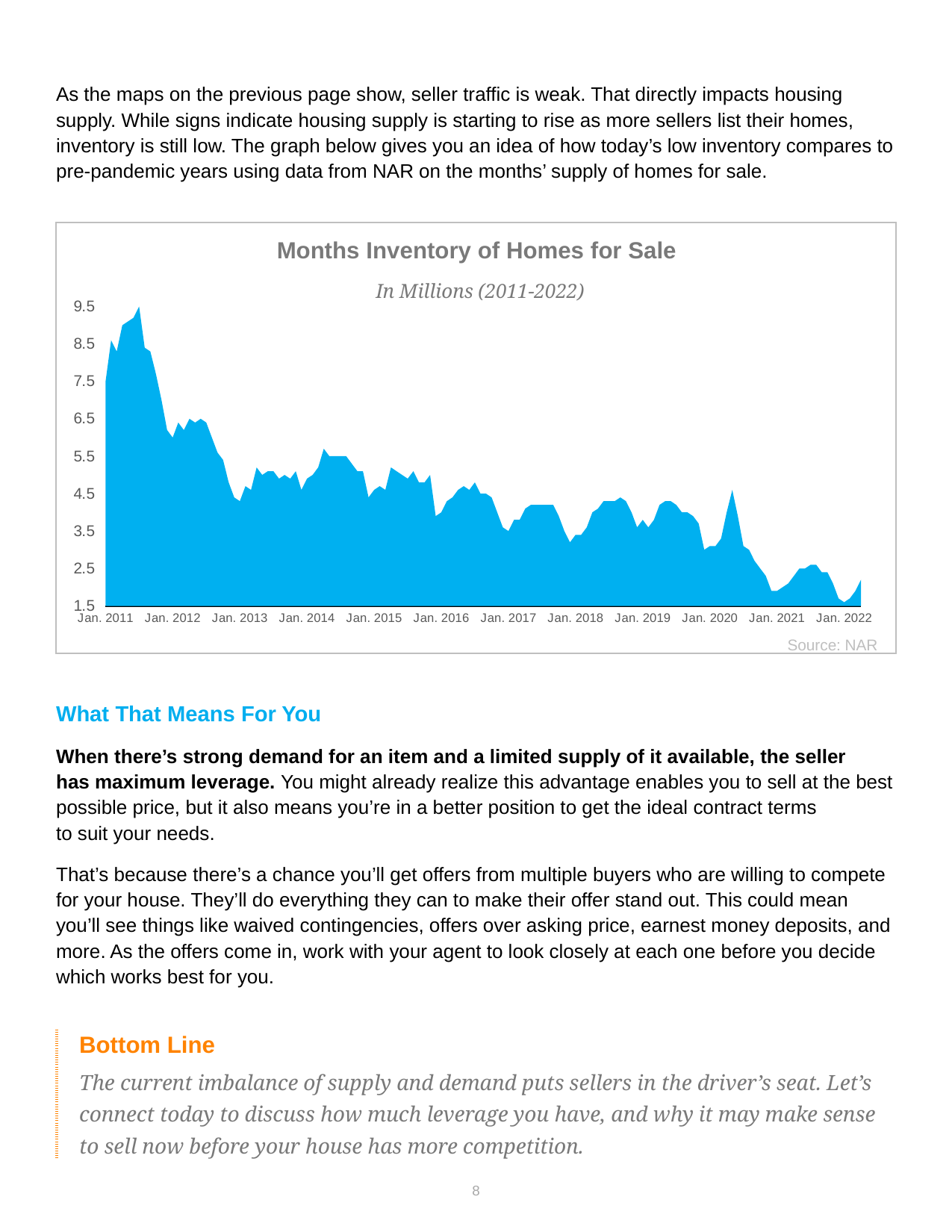
Is the value for Jan. 2021 greater or less than 2.5? less How many year labels are shown on the x axis? 12 Overall, do the values rise or fall from Jan. 2011 to Jan. 2022? Fall What type of chart is shown on the slide? Area chart Is the lowest value on the chart near the start or the end of the period shown? End Is the value for Jan. 2022 greater or less than 2.5? less What is the title of the chart? Months Inventory of Homes for Sale In which year does the chart reach its highest value? 2011 What source is cited for the chart's data? NAR Which is larger, the value for Jan. 2011 or the value for Jan. 2022? Jan. 2011 Is the peak value in 2011 greater or less than 8.5? greater